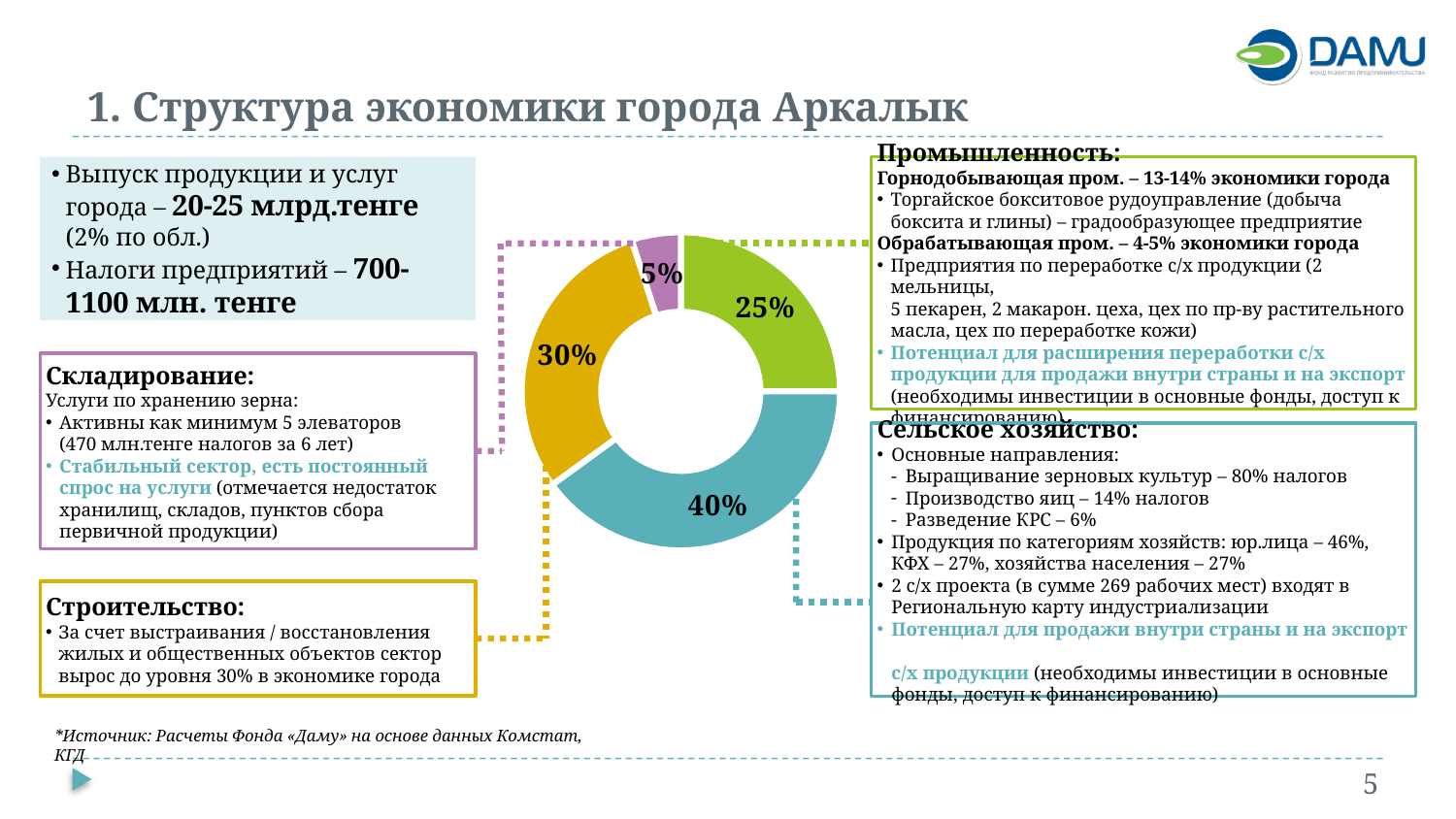
What is the smallest slice of the donut chart? 5% What percentage is shown on the teal slice of the donut chart? 40% What percentage is shown on the green slice of the donut chart? 25% What is the difference between the largest and smallest slices of the donut chart? 35% What percentage is shown on the purple slice of the donut chart? 5% Which sector does the 5% slice of the donut chart connect to on the slide? Складирование What is the largest slice of the donut chart? 40% Which sector does the 40% slice of the donut chart connect to on the slide? Сельское хозяйство How many slices does the donut chart have? 4 Which slice is larger in the donut chart, the green one or the yellow one? The yellow one (30%) What percentage is shown on the yellow slice of the donut chart? 30% What kind of chart is shown on the slide? Pie chart (donut)